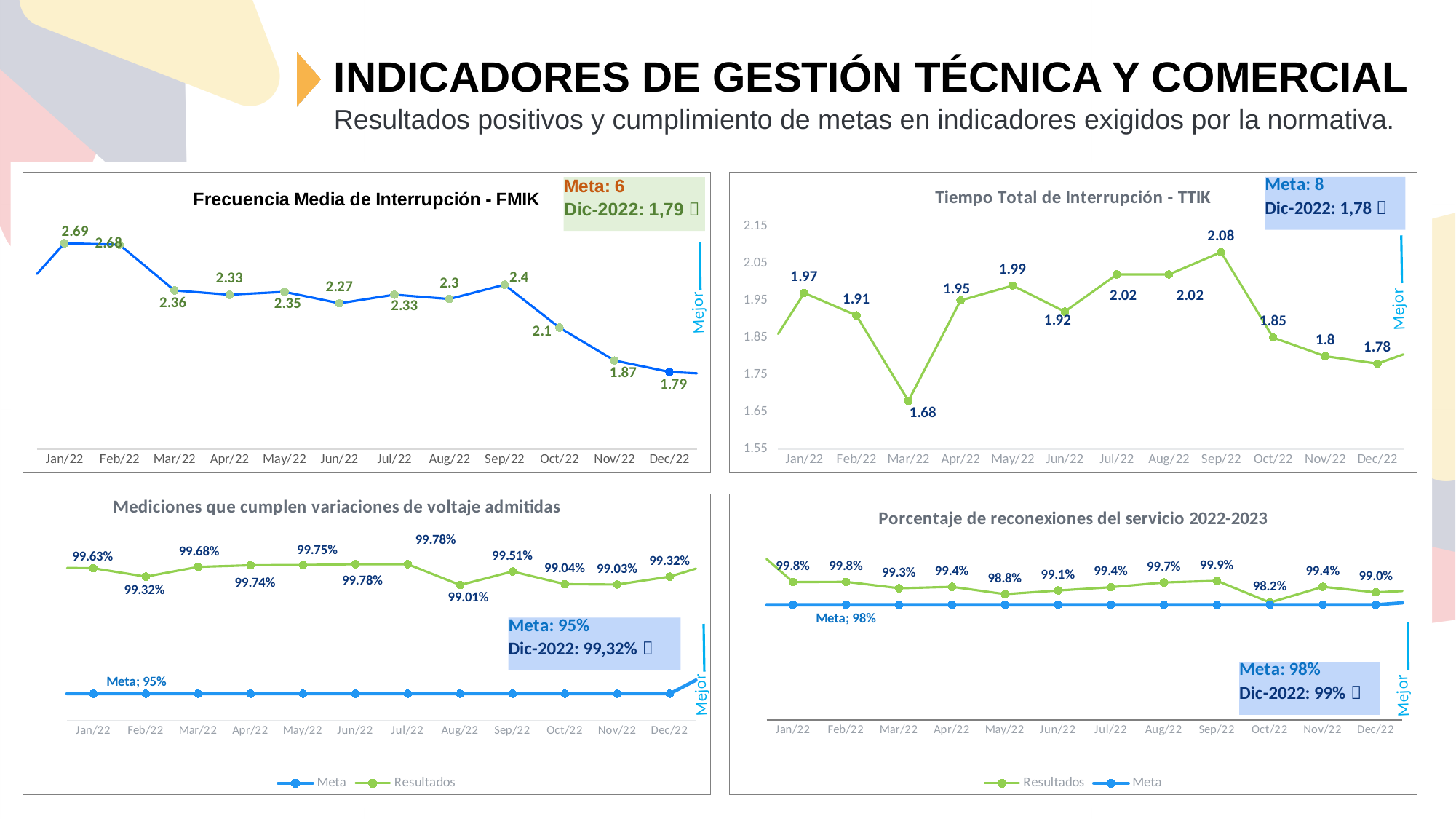
In the 'Mediciones que cumplen variaciones de voltaje admitidas' chart, what is the Resultados value for Aug/22? 99.01% In the 'Porcentaje de reconexiones del servicio 2022-2023' chart, which month has the lowest Resultados value? Oct/22 In the 'Frecuencia Media de Interrupción - FMIK' chart, what is the value for Jun/22? 2.27 In the 'Frecuencia Media de Interrupción - FMIK' chart, which month has the highest value? Jan/22 In the 'Tiempo Total de Interrupción - TTIK' chart, which is larger, the value for Jan/22 or the value for Feb/22? Jan/22 In the 'Tiempo Total de Interrupción - TTIK' chart, what is the value for Mar/22? 1.68 In the 'Tiempo Total de Interrupción - TTIK' chart, how many months are plotted on the x axis? 12 In the 'Mediciones que cumplen variaciones de voltaje admitidas' chart, how many series does the legend list? 2 In the 'Porcentaje de reconexiones del servicio 2022-2023' chart, what is the Resultados value for Sep/22? 99.9% In the 'Frecuencia Media de Interrupción - FMIK' chart, what is the difference between the Jan/22 value and the Dec/22 value? 0.9 In the 'Tiempo Total de Interrupción - TTIK' chart, which month has the highest value? Sep/22 What kind of chart is the 'Porcentaje de reconexiones del servicio 2022-2023' chart? Line chart